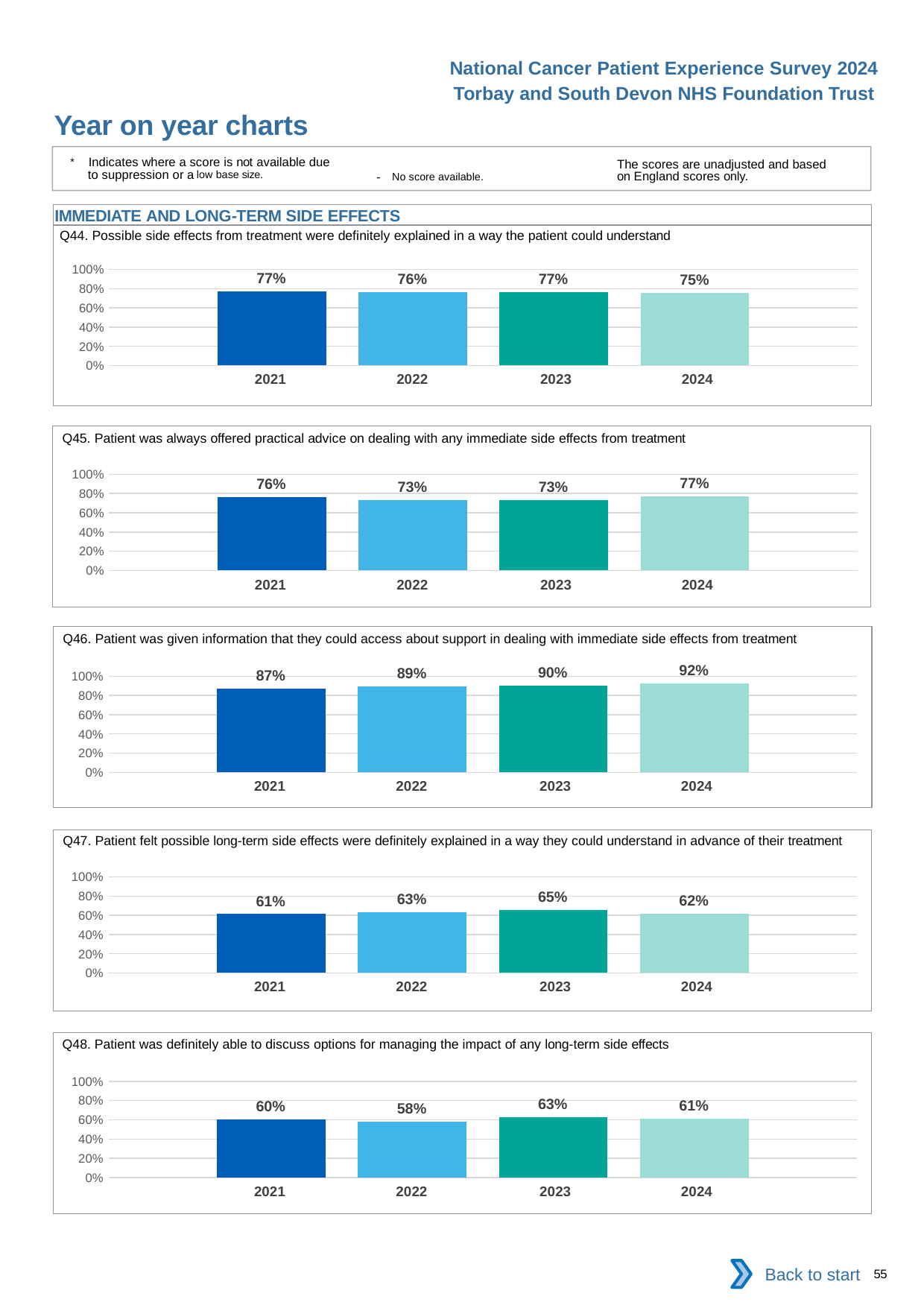
In the Q47 chart, is the value for 2023 greater or less than 80%? less In the Q48 chart, what is the value for 2022? 58% In the Q44 chart, what is the value for 2024? 75% What kind of chart is the Q44 chart? bar chart In the Q45 chart, what is the difference between the 2021 and 2022 values? 3% In the Q46 chart, do the values rise or fall from 2021 to 2024? rise In the Q46 chart, what is the difference between the 2024 and 2021 values? 5% In the Q48 chart, which is larger, the value for 2023 or the value for 2024? 2023 In the Q47 chart, which year has the lowest value? 2021 How many years are plotted in the Q45 chart? 4 What is the section heading above the Q44 chart? IMMEDIATE AND LONG-TERM SIDE EFFECTS In the Q45 chart, which year has the highest value? 2024